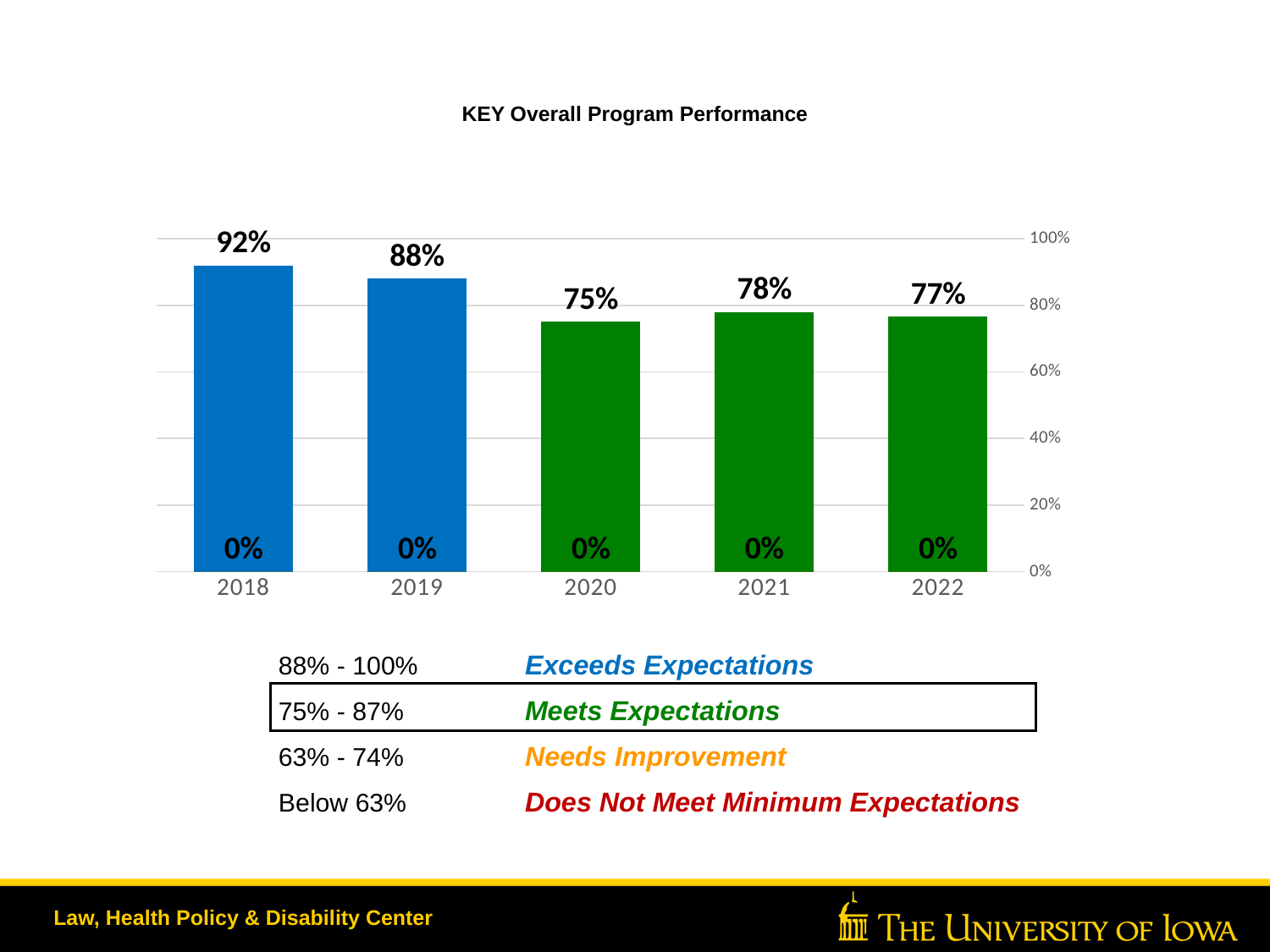
What is the value for 2022? 77% Which is larger, the value for 2019 or the value for 2021? 2019 What is the value for 2020? 75% Do the values rise or fall from 2018 to 2020? fall What kind of chart is shown on the slide? bar chart What is the value for 2018? 92% What is the difference between the values for 2021 and 2020? 3% Which year has the highest value? 2018 Which year has the lowest value? 2020 What is the difference between the values for 2018 and 2019? 4% What is the title of the chart? KEY Overall Program Performance How many years are shown on the x axis? 5